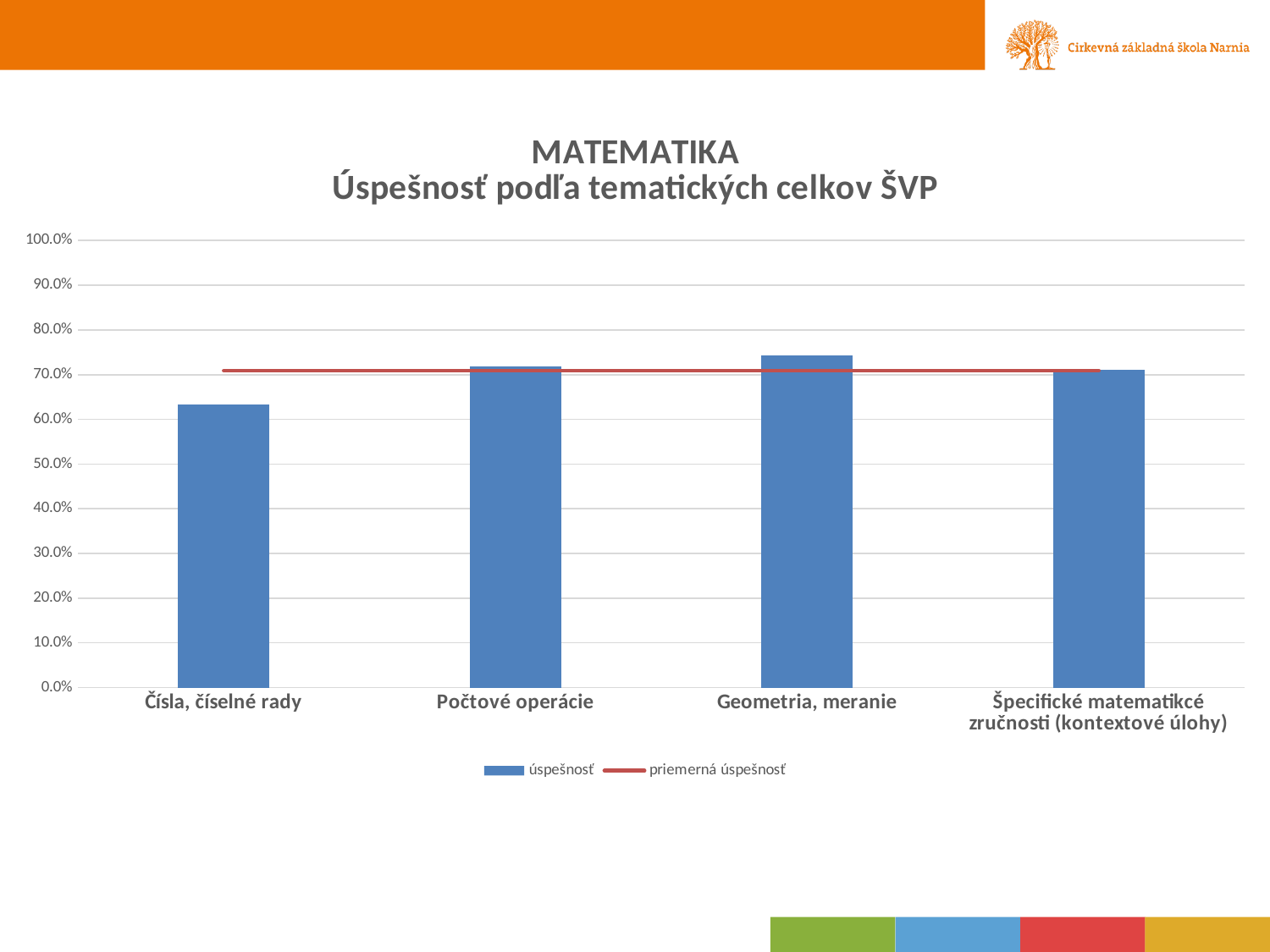
Which category has the lowest úspešnosť bar? Čísla, číselné rady How many categories are shown on the x axis of the chart? 4 How many series does the chart's legend list? 2 Which category has the highest úspešnosť bar? Geometria, meranie Is the úspešnosť value for Počtové operácie greater or less than 80.0%? less What kind of chart is shown on the slide? combination bar and line chart Is the úspešnosť value for Čísla, číselné rady greater or less than 60.0%? greater What is the title of the chart? MATEMATIKA Úspešnosť podľa tematických celkov ŠVP Is the úspešnosť value for Geometria, meranie greater or less than 70.0%? greater What are the two entries listed in the chart's legend? úspešnosť and priemerná úspešnosť Which has the larger úspešnosť value: Čísla, číselné rady or Geometria, meranie? Geometria, meranie